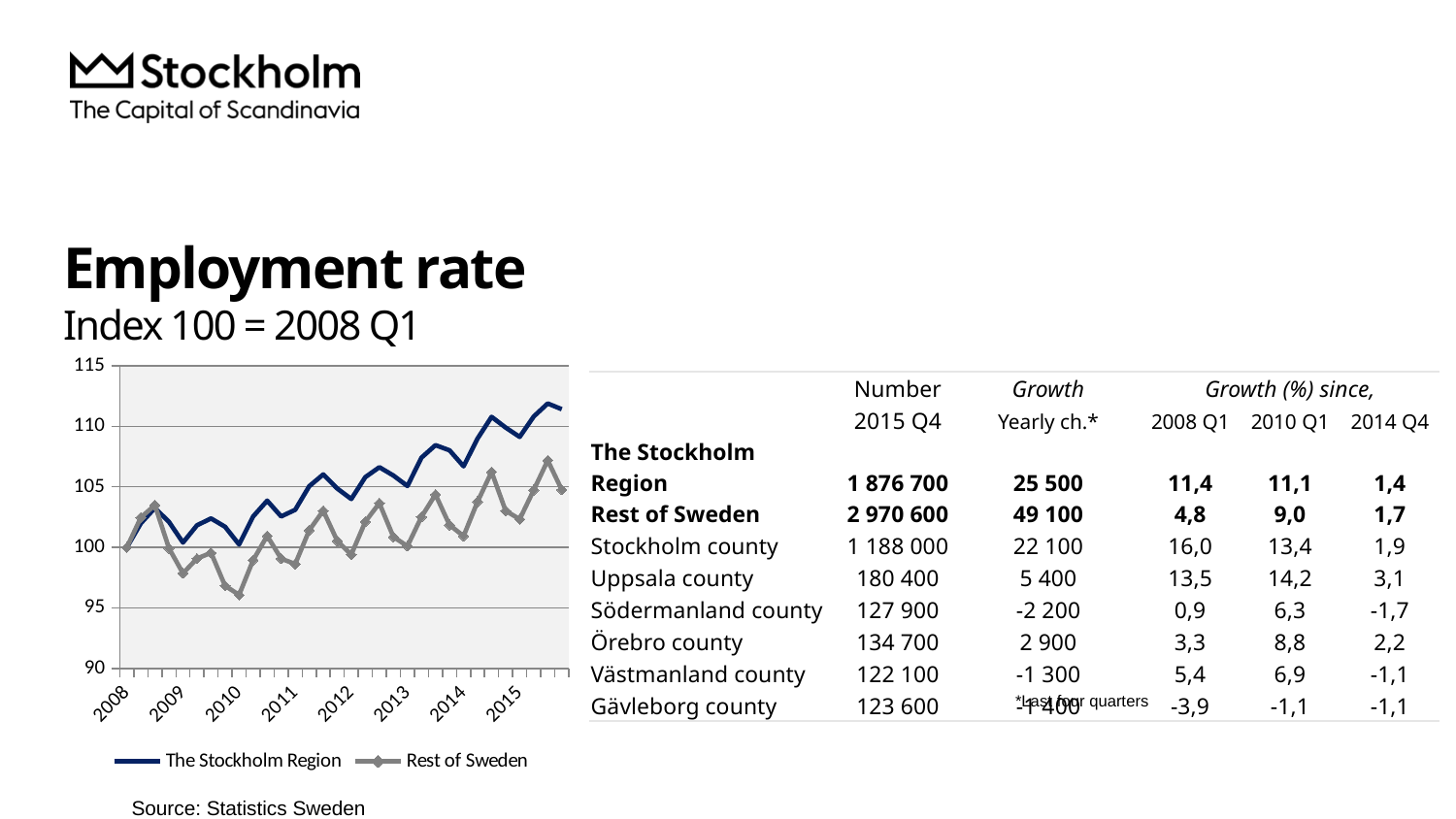
Which series is higher at the end of the chart in 2015? The Stockholm Region Which series dips lower around 2010, The Stockholm Region or Rest of Sweden? Rest of Sweden Overall, do the values for The Stockholm Region rise or fall from 2008 to 2015? rise How many series does the chart legend list? 2 Is the value for The Stockholm Region in 2014 greater or less than 105? greater What is the title of the chart? Employment rate What are the two series named in the chart legend? The Stockholm Region and Rest of Sweden Is the lowest value for Rest of Sweden, around 2010, greater or less than 100? less What kind of chart is shown on the slide? line chart How many year labels are shown on the x axis of the chart? 8 Is the value for The Stockholm Region at the end of 2015 greater or less than 110? greater